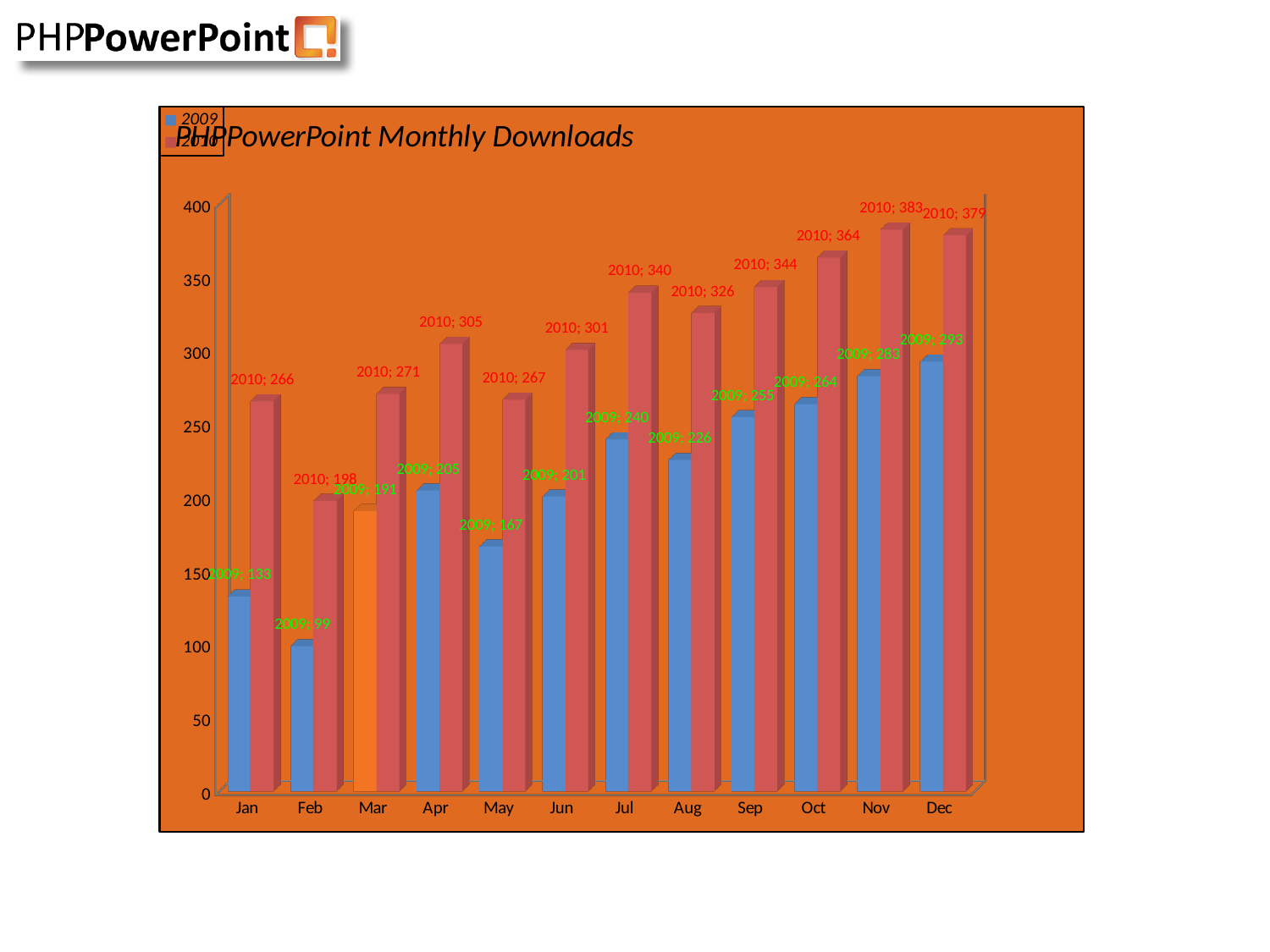
How many series does the legend list? 2 How many months are shown on the x axis? 12 Which is larger, the 2010 value for Mar or the 2010 value for May? 2010 value for Mar What is the 2009 value for Feb? 99 Is the 2009 value for Oct greater or less than 250? greater What is the 2009 value for Jul? 240 What is the title of the chart? PHPPowerPoint Monthly Downloads What kind of chart is shown? bar chart What is the 2010 value for Nov? 383 Which month has the lowest 2009 value? Feb Which month has the highest 2010 value? Nov What is the difference between the 2010 and 2009 values for Dec? 86